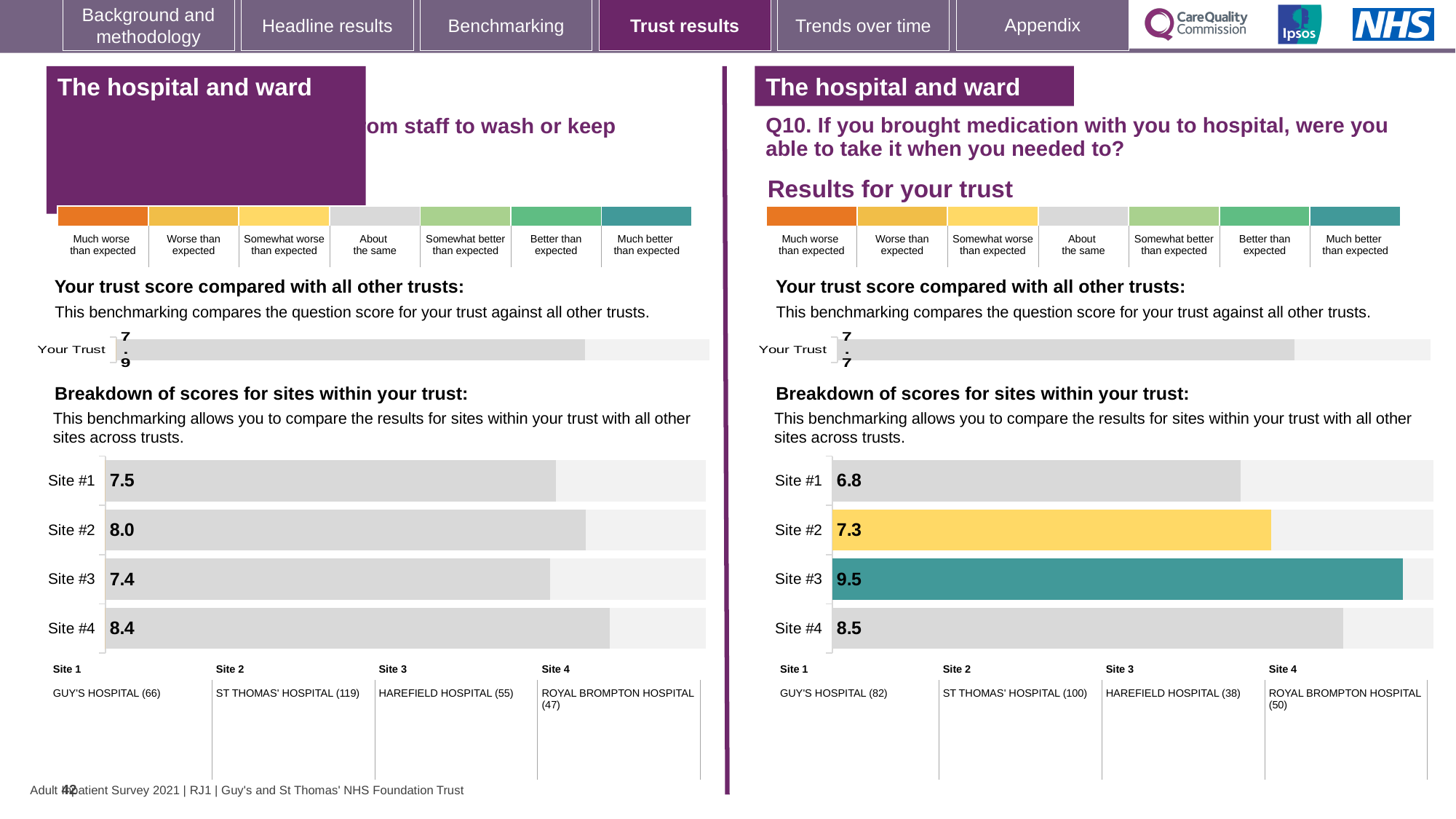
On the right-hand (Q10) site breakdown chart, which has the higher score, Site #2 or Site #4? Site #4 What type of chart is used for the site breakdown on the left-hand panel? Bar chart How many sites are shown in the right-hand (Q10) site breakdown chart? 4 On the right-hand (Q10) 'Your trust score compared with all other trusts' chart, what is the score for Your Trust? 7.7 On the right-hand (Q10) site breakdown chart, what is the difference between the scores for Site #3 and Site #1? 2.7 On the left-hand site breakdown chart, what is the score for Site #2? 8.0 On the left-hand site breakdown chart, which site has the highest score? Site #4 On the right-hand (Q10) site breakdown chart, what is the score for Site #3? 9.5 On the right-hand (Q10) site breakdown chart, which site has the lowest score? Site #1 On the left-hand site breakdown chart, which has the higher score, Site #1 or Site #2? Site #2 On the right-hand (Q10) site breakdown chart, what colour is the bar for Site #3? Teal (much better than expected) On the left-hand site breakdown chart, what is the difference between the scores for Site #4 and Site #3? 1.0